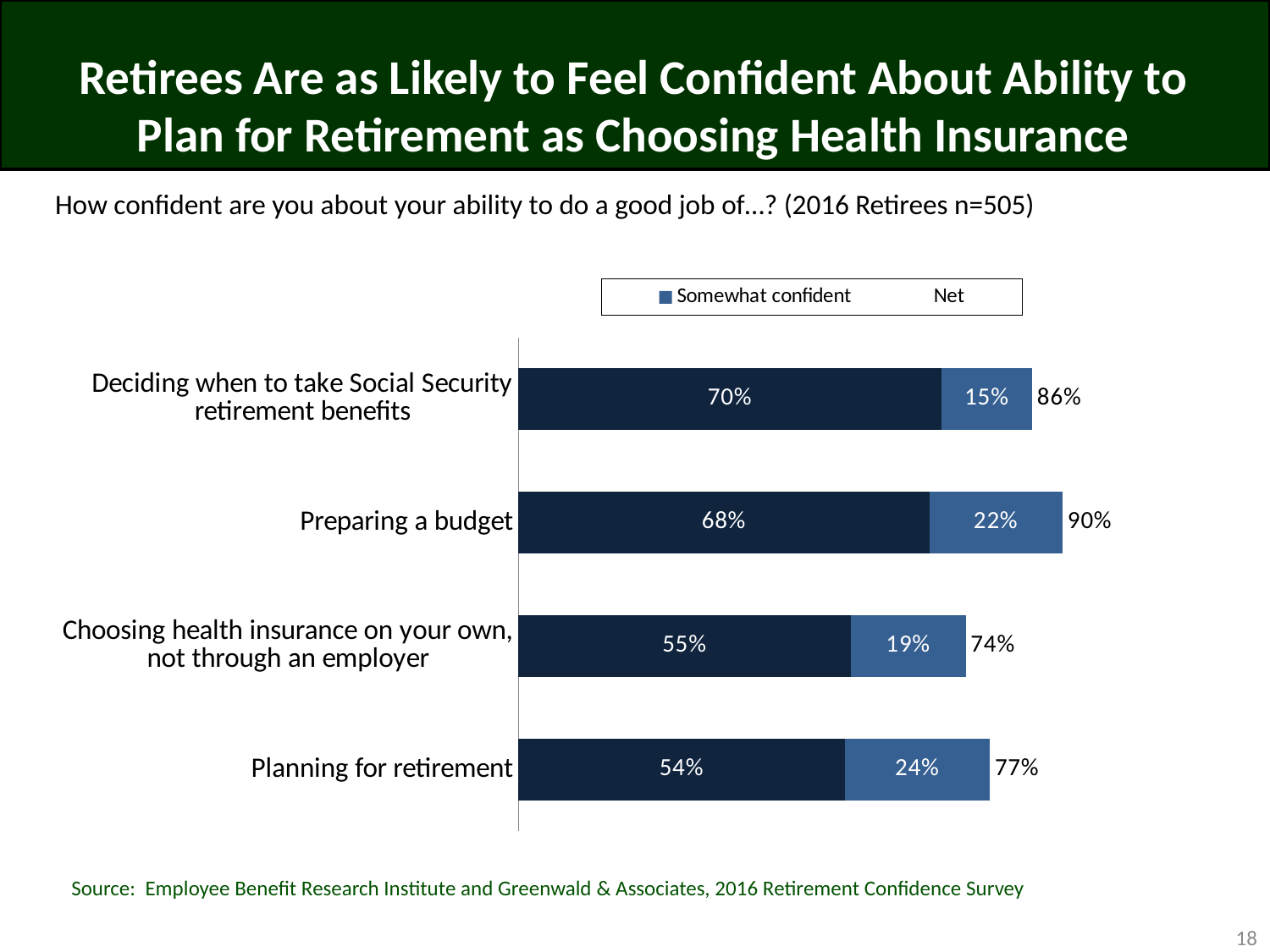
What is the Net value shown for "Planning for retirement"? 77% What is the "Somewhat confident" value for "Preparing a budget"? 22% Which has a larger "Somewhat confident" value: "Preparing a budget" or "Choosing health insurance on your own, not through an employer"? Preparing a budget What is the difference between the "Somewhat confident" values for "Planning for retirement" and "Deciding when to take Social Security retirement benefits"? 9 percentage points What value is printed on the dark navy segment of the "Deciding when to take Social Security retirement benefits" bar? 70% What survey question is the chart based on, as stated above the chart? How confident are you about your ability to do a good job of…? (2016 Retirees n=505) How many categories are shown in the chart? 4 Which category has the highest Net value? Preparing a budget What kind of chart is shown on the slide? Stacked bar chart What is the Net value shown for "Choosing health insurance on your own, not through an employer"? 74% Which category has the lowest Net value? Choosing health insurance on your own, not through an employer Which category has the highest "Somewhat confident" value? Planning for retirement